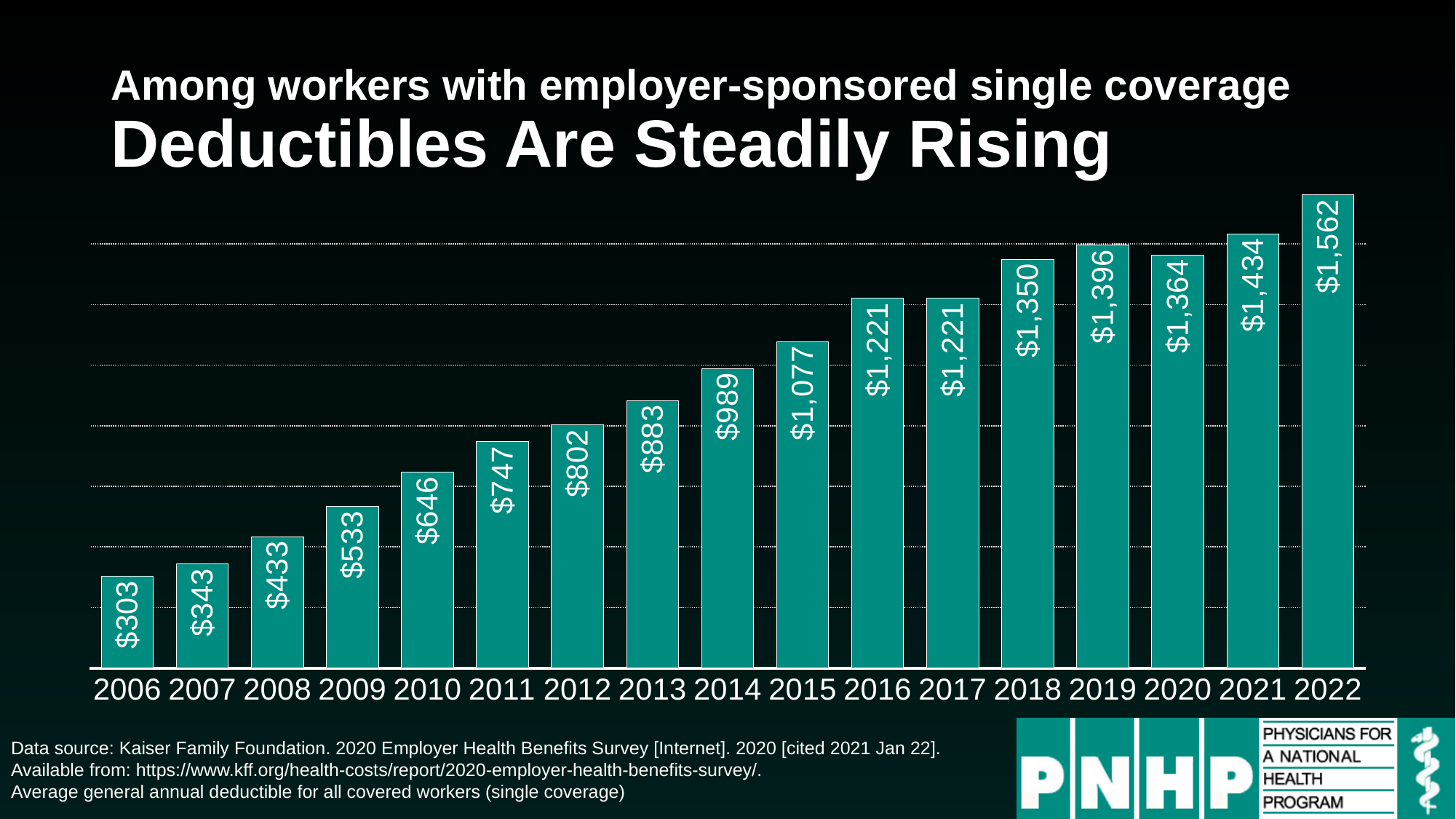
How many years are shown on the x axis? 17 What is the difference between the deductible in 2019 and the deductible in 2020? $32 Which year has the highest deductible? 2022 Which year has the lowest deductible? 2006 What is the average deductible shown for 2014? $989 What is the main title of the chart? Deductibles Are Steadily Rising What is the average deductible shown for 2020? $1,364 What kind of chart is this? bar chart Which is larger, the deductible in 2019 or the deductible in 2020? 2019 Do the deductible values generally rise or fall from 2006 to 2022? rise What is the average deductible shown for 2006? $303 What is the difference between the deductible in 2022 and the deductible in 2006? $1,259